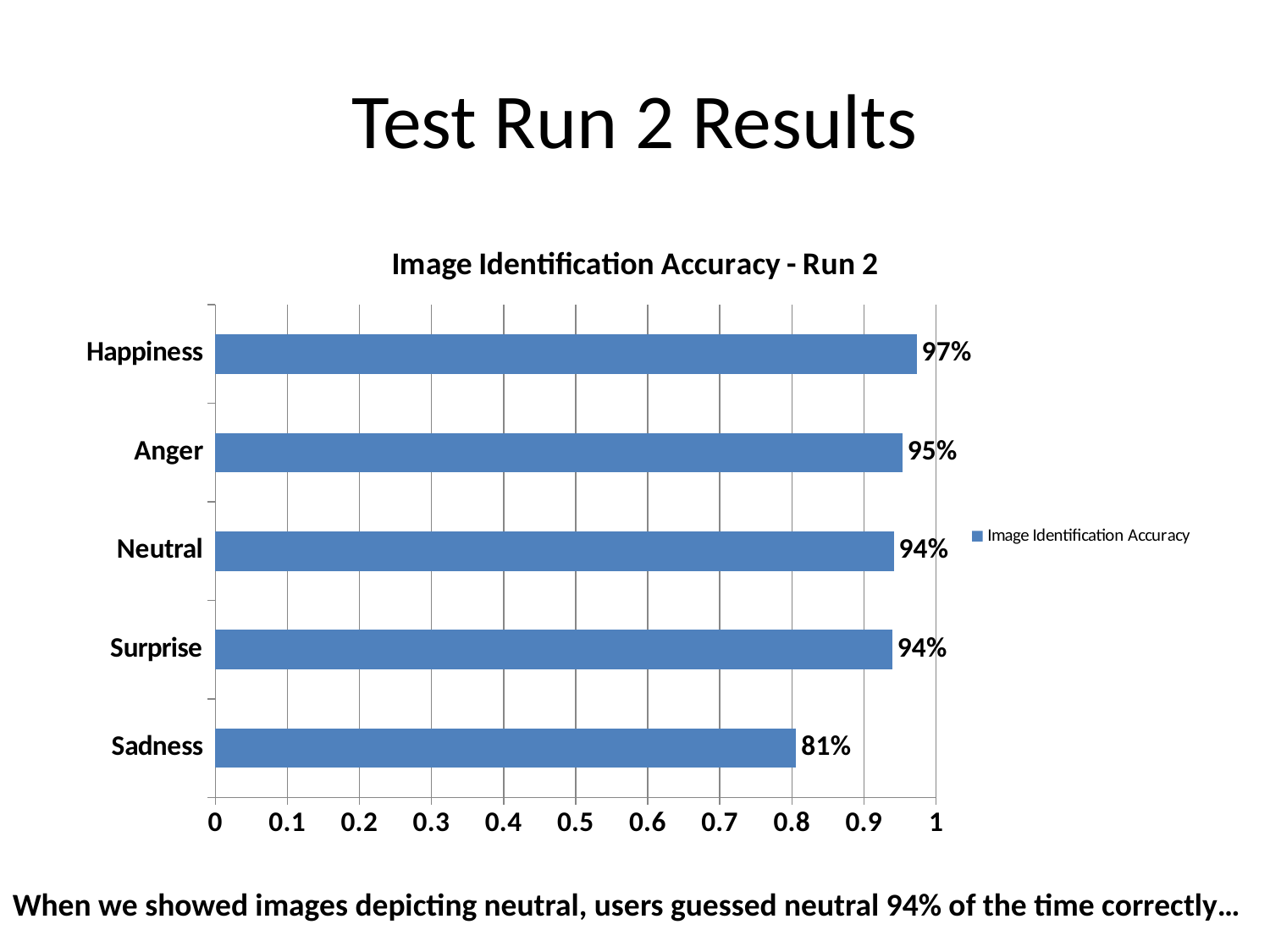
What is the title of the chart? Image Identification Accuracy - Run 2 What kind of chart is shown on the slide? Bar chart What is the difference in Image Identification Accuracy between Happiness and Sadness? 16% Is the value for Sadness greater or less than 0.9? less Which has a higher Image Identification Accuracy, Anger or Sadness? Anger Which category has the lowest Image Identification Accuracy? Sadness How many categories are shown in the chart? 5 Which category has the highest Image Identification Accuracy? Happiness What is the Image Identification Accuracy for Happiness? 97% What is the Image Identification Accuracy for Sadness? 81% What is the Image Identification Accuracy for Anger? 95% How many series does the legend list? 1